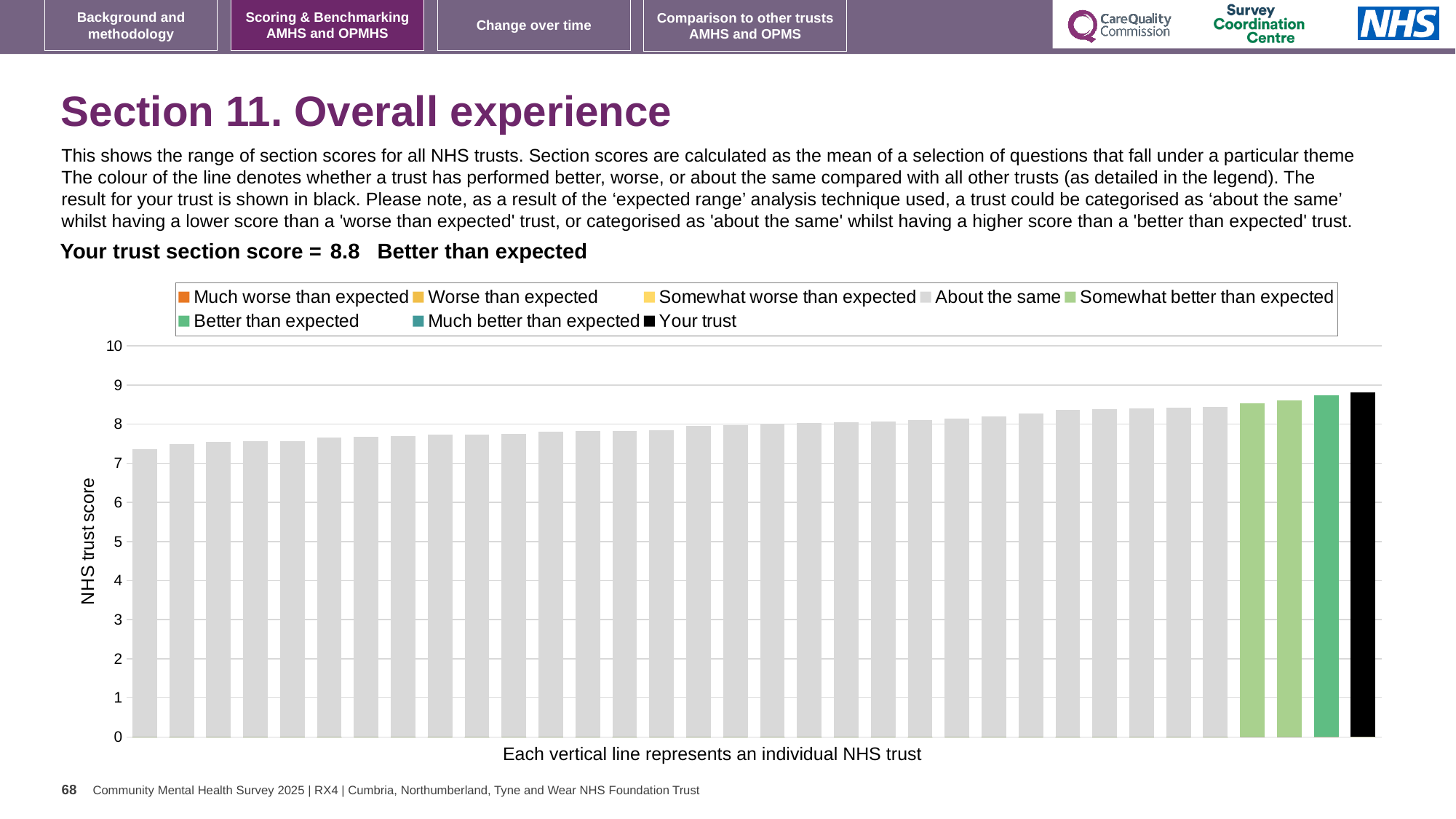
Is the value for Your trust greater or less than 8? greater What is the section score for your trust shown on the slide? 8.8 How is your trust's section score categorised compared with other trusts? Better than expected How many entries does the chart legend list? 8 Do the bar values rise or fall from left to right across the chart? rise Is the value of the leftmost (lowest) bar greater or less than 7? greater How many bars are coloured darker green (Better than expected)? 1 What is the label on the vertical axis of the chart? NHS trust score What colour is the bar representing your trust? black What kind of chart is shown on the slide? bar chart How many bars are coloured light green (Somewhat better than expected)? 2 Is the value of the leftmost (lowest) bar greater or less than 8? less